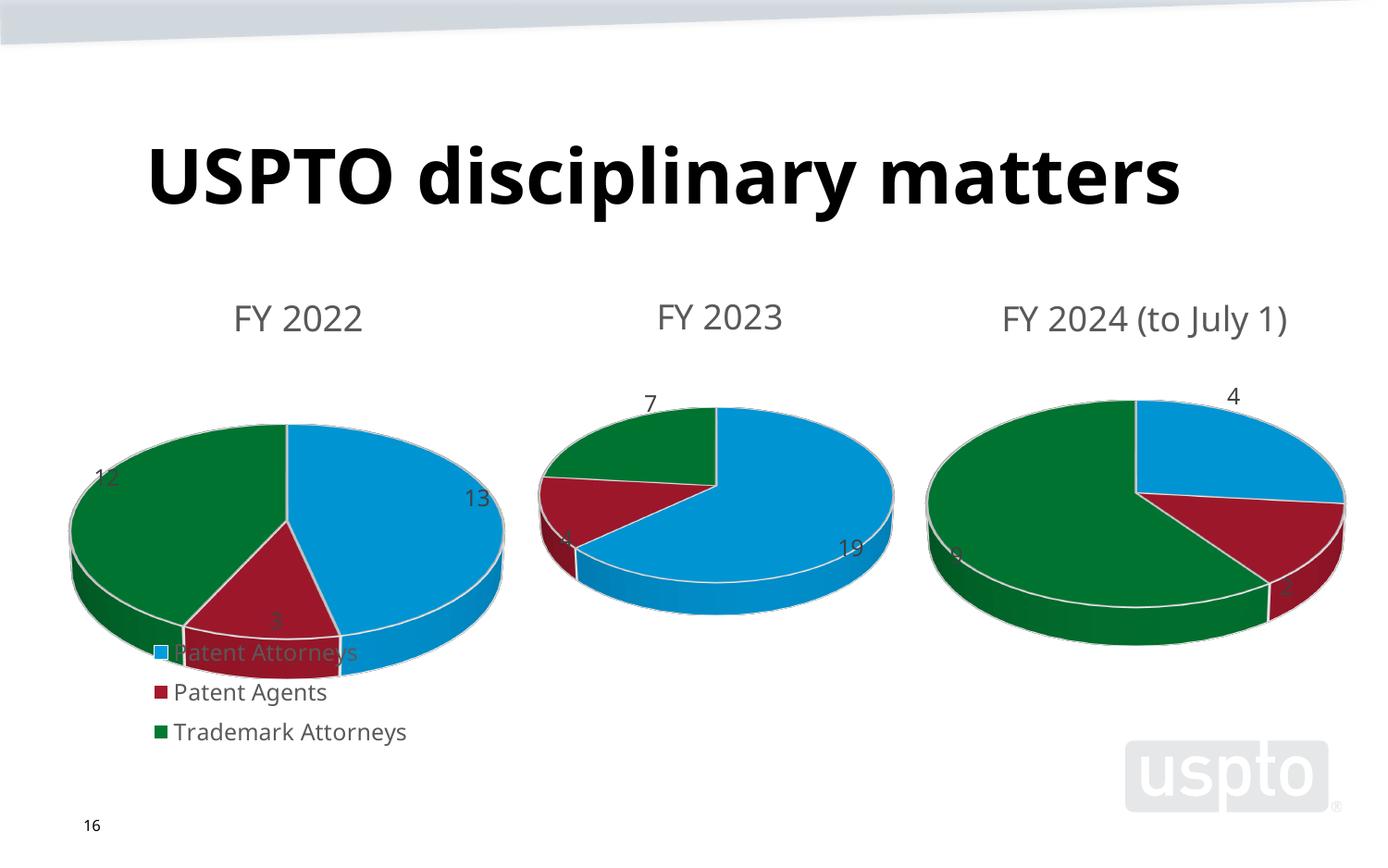
What type of chart is used for FY 2022, FY 2023 and FY 2024 on this slide? Pie chart In the FY 2022 pie chart, what is the value for Patent Agents? 3 In the FY 2022 pie chart, what is the value for Trademark Attorneys? 12 In the FY 2022 pie chart, what is the difference between the Patent Attorneys value and the Patent Agents value? 10 In the FY 2023 pie chart, what is the value for Trademark Attorneys? 7 In the FY 2022 pie chart, what is the value for Patent Attorneys? 13 In the FY 2024 (to July 1) pie chart, what is the value for Patent Attorneys? 4 How many categories does the legend list for the pie charts? 3 In the FY 2022 pie chart, which category has the smallest slice? Patent Agents In the FY 2023 pie chart, what is the value for Patent Attorneys? 19 In the FY 2024 (to July 1) pie chart, which category has the largest slice? Trademark Attorneys In the FY 2023 pie chart, which category has the largest slice? Patent Attorneys